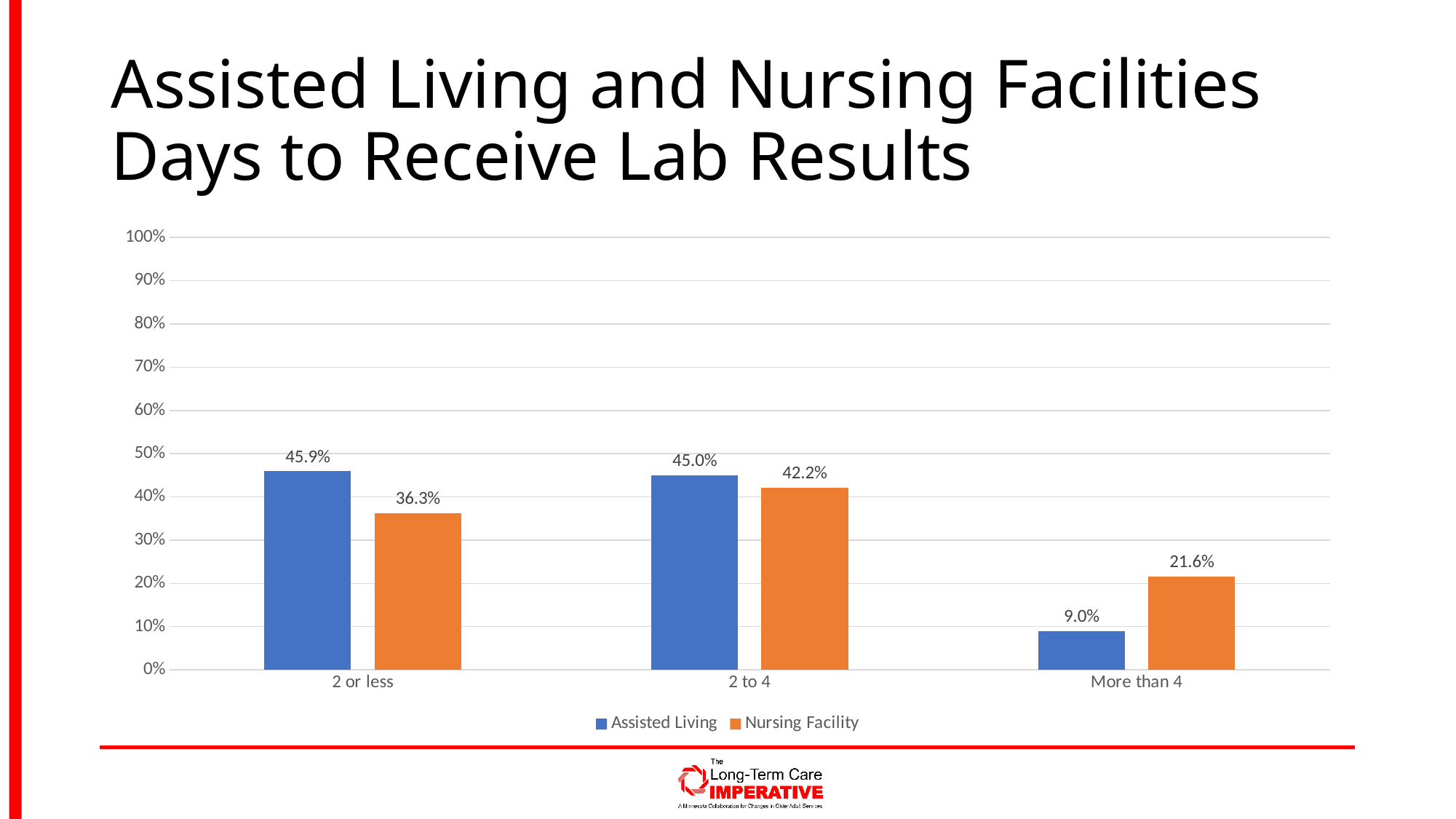
What is the Nursing Facility value for the 'More than 4' category? 21.6% Which category has the highest Nursing Facility value? 2 to 4 For the 'More than 4' category, which series has the larger value, Assisted Living or Nursing Facility? Nursing Facility What is the Nursing Facility value for the '2 to 4' category? 42.2% Is the Assisted Living value for '2 to 4' greater or less than 40%? greater How many series does the legend list? 2 How many categories are shown on the x axis? 3 What is the Assisted Living value for the '2 or less' category? 45.9% What kind of chart is shown on the slide? Bar chart What is the difference between the Assisted Living and Nursing Facility values for '2 or less'? 9.6% Which category has the lowest Assisted Living value? More than 4 What is the difference between the Nursing Facility and Assisted Living values for 'More than 4'? 12.6%